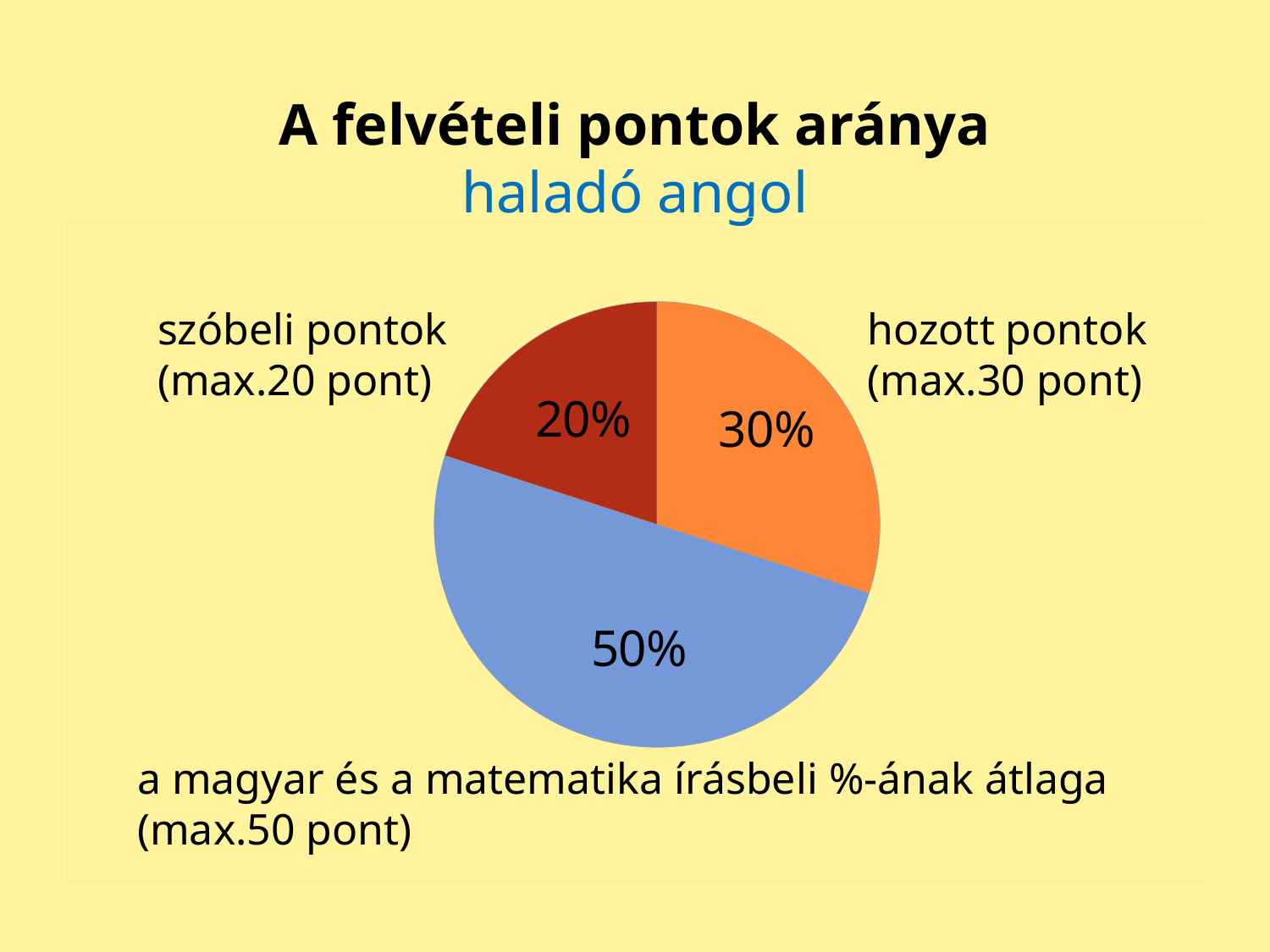
What is the difference between the shares of 'hozott pontok' and 'szóbeli pontok'? 10% What kind of chart is shown on the slide? pie chart What share of the pie does 'a magyar és a matematika írásbeli %-ának átlaga' have? 50% What share of the pie does 'szóbeli pontok' have? 20% What is the maximum number of points for 'hozott pontok' according to the slide? 30 pont Which slice of the pie is the smallest? szóbeli pontok Which slice of the pie is the largest? a magyar és a matematika írásbeli %-ának átlaga What is the title of the chart? A felvételi pontok aránya haladó angol What share of the pie does 'hozott pontok' have? 30% What colour is the slice for 'szóbeli pontok'? dark red How many slices does the pie chart have? 3 Which is larger, the share for 'hozott pontok' or the share for 'szóbeli pontok'? hozott pontok